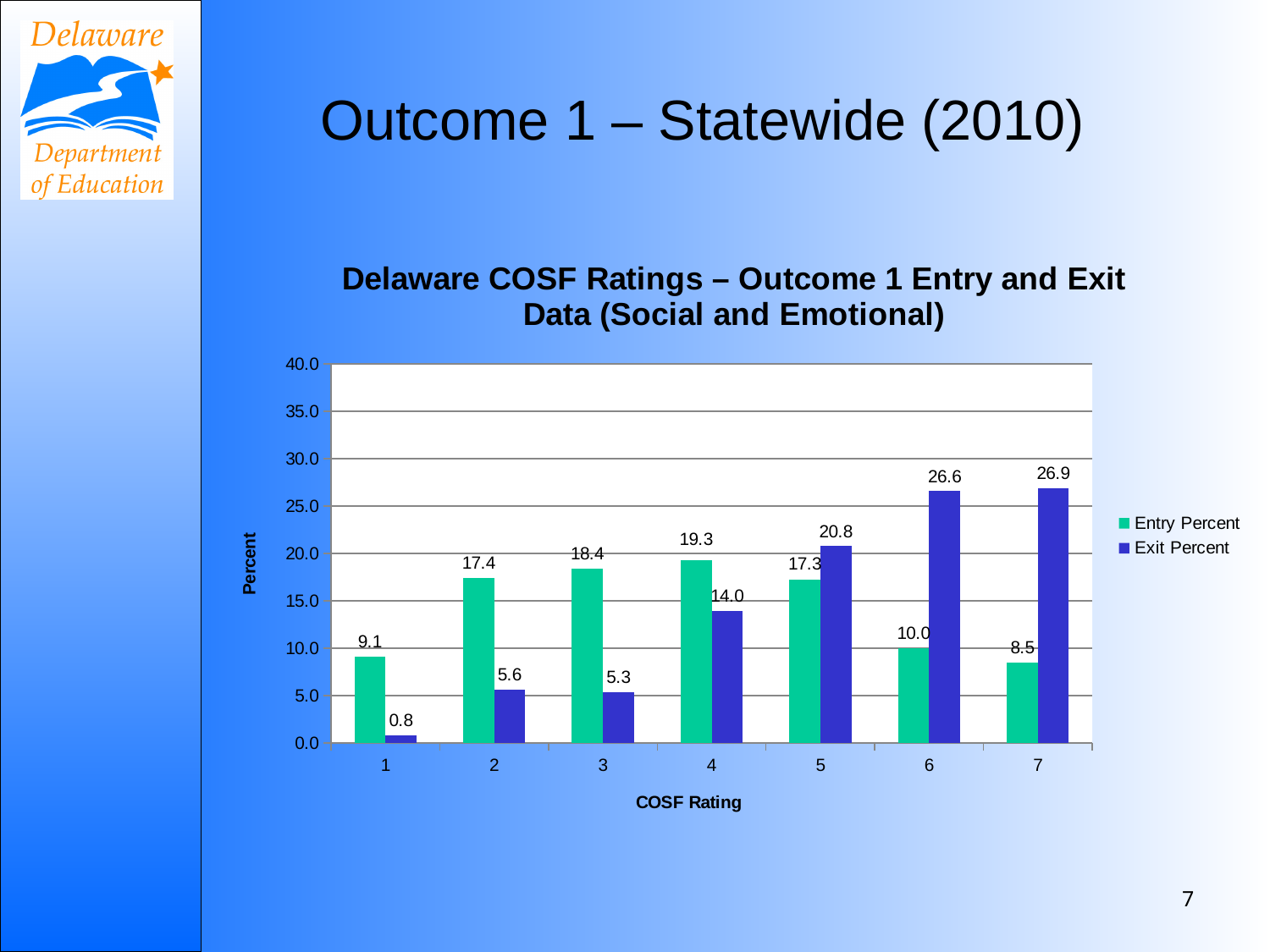
For COSF Rating 3, which is larger, the Entry Percent or the Exit Percent? Entry Percent Which COSF Rating has the highest Exit Percent? 7 How many series does the legend list? 2 How many COSF Rating categories are shown on the x axis? 7 Which COSF Rating has the lowest Entry Percent? 7 What is the Exit Percent for COSF Rating 1? 0.8 What is the label of the y axis? Percent What is the difference between the Exit Percent and the Entry Percent for COSF Rating 7? 18.4 What is the Exit Percent for COSF Rating 6? 26.6 Is the Exit Percent for COSF Rating 5 greater or less than 20.0? greater What kind of chart is shown on the slide? Bar chart What is the Entry Percent for COSF Rating 4? 19.3